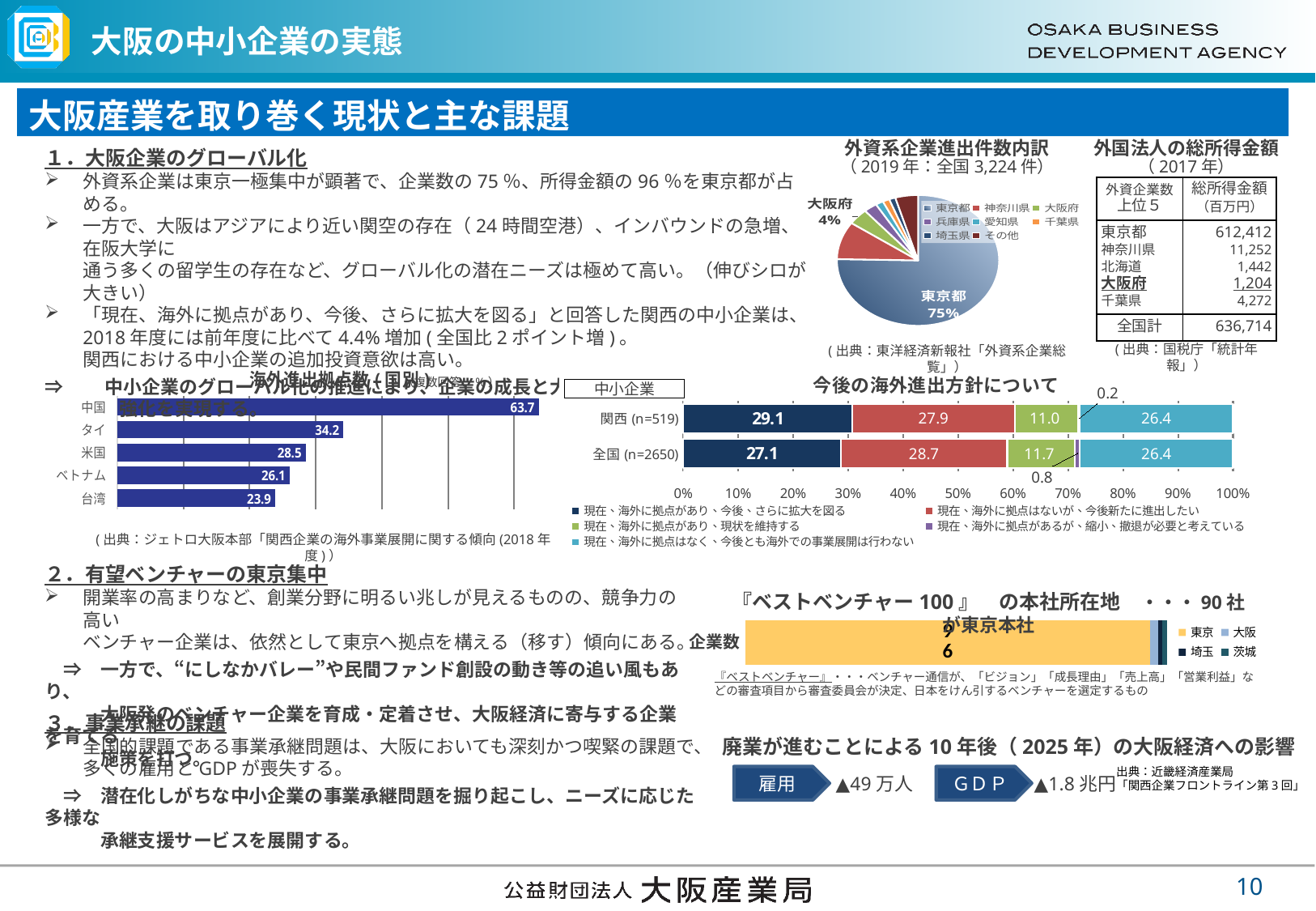
What kind of chart is 海外進出拠点数（国別）? Bar chart In the pie chart 外資系企業進出件数内訳, what share does 大阪府 hold? 4% In the pie chart 外資系企業進出件数内訳, what share does 東京都 hold? 75% How many entries does the legend of the pie chart 外資系企業進出件数内訳 list? 8 In the stacked bar chart 今後の海外進出方針について, what is the value of the first (dark blue) segment for 関西 (n=519)? 29.1 In the bar chart 海外進出拠点数（国別）, which country has the lowest value? 台湾 In the bar chart 海外進出拠点数（国別）, what is the value for 中国? 63.7 How many series does the legend of the stacked bar chart 今後の海外進出方針について list? 5 In the bar chart 海外進出拠点数（国別）, what is the value for タイ? 34.2 In the bar chart 海外進出拠点数（国別）, how many countries are shown? 5 In the stacked bar chart 今後の海外進出方針について, which is larger for the second (red) segment: 関西 (n=519) or 全国 (n=2650)? 全国 (n=2650) In the bar chart 海外進出拠点数（国別）, what is the difference between 中国 and タイ? 29.5